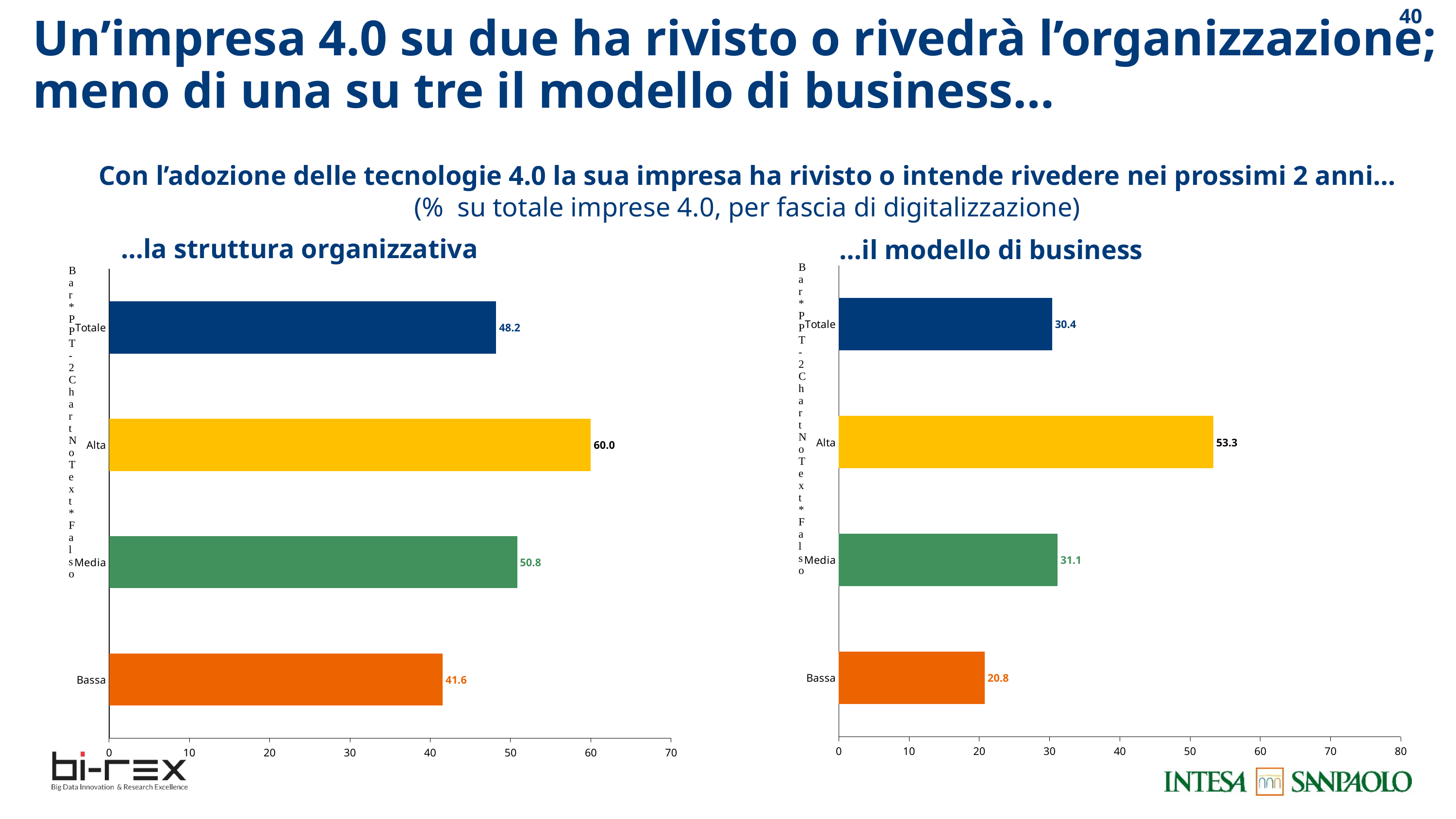
In the '...la struttura organizzativa' chart, which category has the highest value? Alta In the '...la struttura organizzativa' chart, what is the value for Totale? 48.2 In the '...la struttura organizzativa' chart, what is the difference between the values for Alta and Bassa? 18.4 In the '...il modello di business' chart, which is larger, the value for Media or the value for Totale? Media What kind of chart is the '...la struttura organizzativa' chart? bar chart In the '...il modello di business' chart, which category has the lowest value? Bassa In the '...la struttura organizzativa' chart, what is the value for Media? 50.8 In the '...il modello di business' chart, what colour is the bar for Alta? yellow In the '...il modello di business' chart, what is the difference between the values for Alta and Totale? 22.9 How many categories are shown in the '...il modello di business' chart? 4 In the '...la struttura organizzativa' chart, is the value for Media greater or less than 50? greater In the '...il modello di business' chart, what is the value for Bassa? 20.8